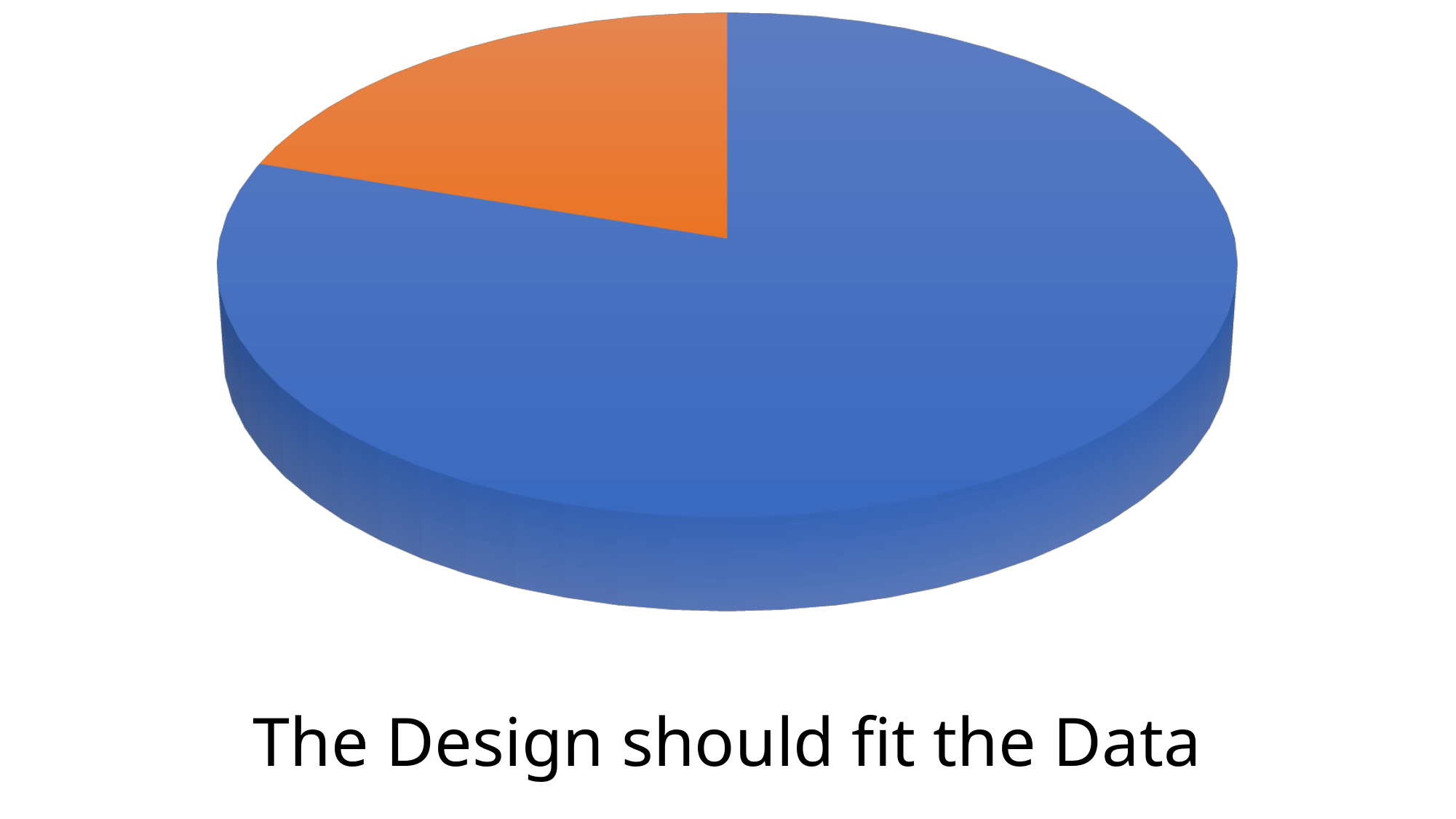
What kind of chart is shown on the slide? pie chart What colours are the two slices of the pie chart? blue and orange How many slices does the pie chart have? 2 Which slice of the pie chart is the smallest? the orange slice Is the orange slice's share of the pie greater or less than 50%? less Is the blue slice's share of the pie greater or less than 50%? greater Which slice is larger, the blue slice or the orange slice? the blue slice Which slice of the pie chart is the largest? the blue slice What text appears below the pie chart? The Design should fit the Data